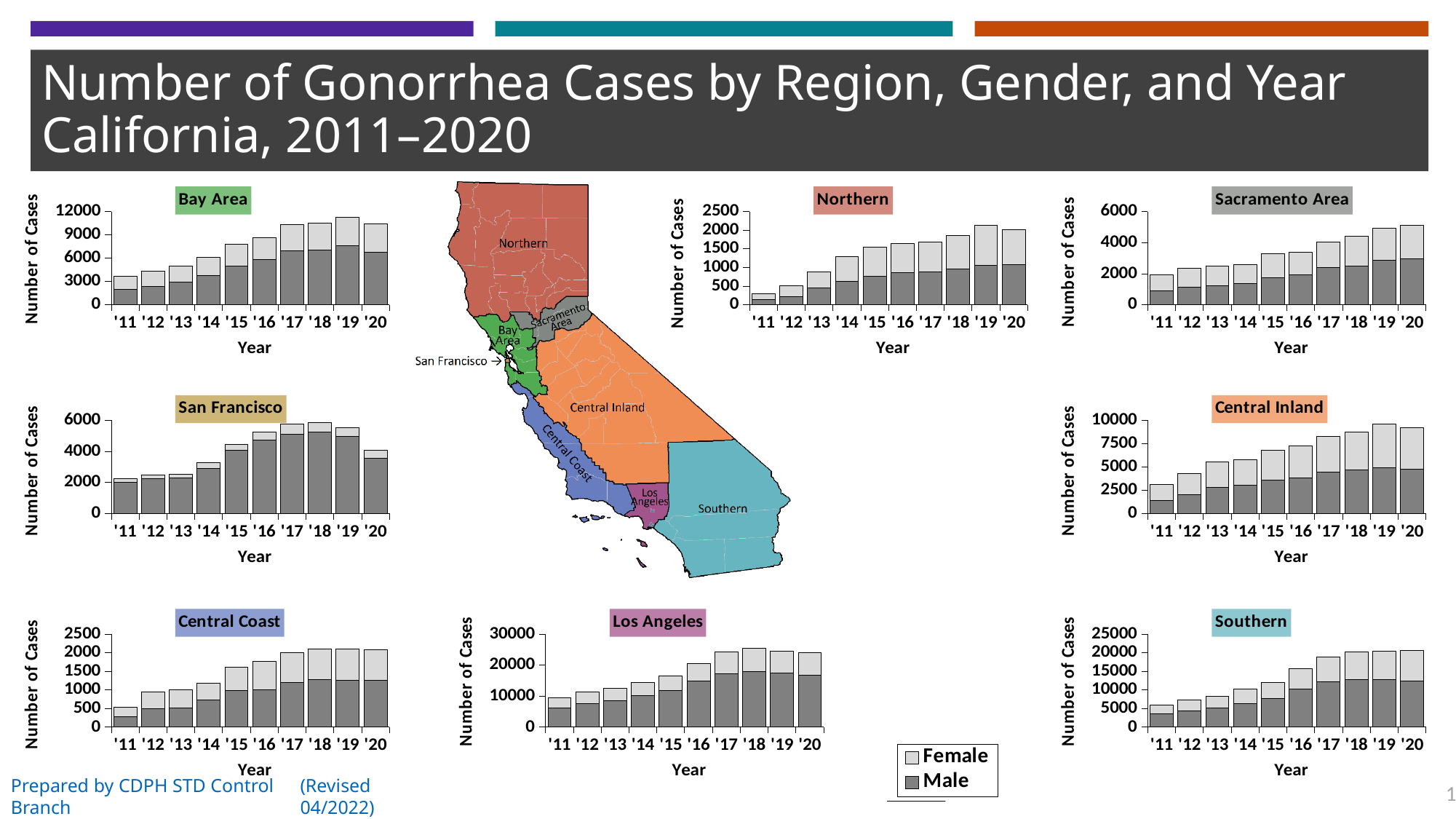
Which legend entry is shown in dark gray? Male How many years are shown on the x axis of the Northern chart? 10 In the Bay Area chart, which year has the highest total number of cases? '19 In the Southern chart, is the total value for '11 greater or less than 10000? less In the Northern chart, is the total value for '11 greater or less than 500? less In the San Francisco chart, which year has the lowest total number of cases? '11 In the Central Inland chart, is the total value for '19 greater or less than 7500? greater In the Los Angeles chart, which year has the highest total number of cases? '18 What kind of chart is the Bay Area chart? bar chart In the Los Angeles chart, which year has the larger total, '15 or '16? '16 How many series does the legend list? 2